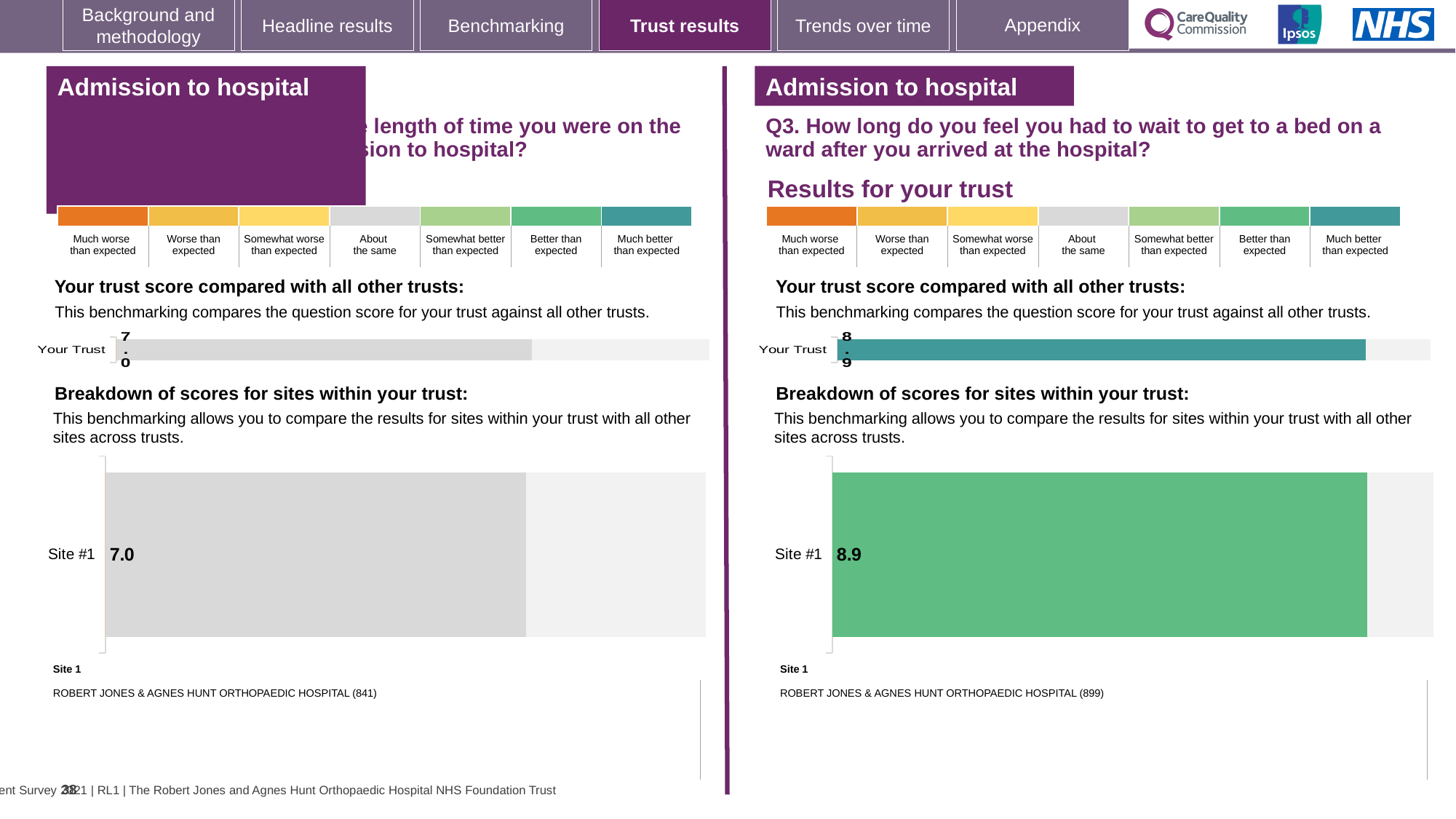
In the left-hand breakdown chart, which benchmarking category colour does the Site #1 bar use? Grey (About the same) On the left-hand side of the slide, what is the score shown for Site #1 in the breakdown of scores chart? 7.0 On the right-hand side of the slide (Q3), what is the score shown for Site #1 in the breakdown of scores chart? 8.9 How many sites are plotted in the breakdown of scores chart on the left-hand side of the slide? 1 Which site name is listed as Site 1 under the right-hand (Q3) breakdown chart? ROBERT JONES & AGNES HUNT ORTHOPAEDIC HOSPITAL (899) Which Site #1 score is larger: the one in the left-hand breakdown chart or the one in the right-hand (Q3) breakdown chart? The right-hand (Q3) chart How many sites are plotted in the breakdown of scores chart on the right-hand side of the slide (Q3)? 1 In the right-hand (Q3) breakdown chart, which benchmarking category colour does the Site #1 bar use? Green (Better than expected) On the left-hand side of the slide, what value is shown for 'Your Trust' in the trust score chart? 7.0 What type of chart is used to show the Site #1 score in the breakdown of scores section on the right-hand side of the slide? Bar chart On the right-hand side of the slide (Q3), what value is shown for 'Your Trust' in the trust score chart? 8.9 What is the difference between the Site #1 score in the right-hand (Q3) breakdown chart and the Site #1 score in the left-hand breakdown chart? 1.9